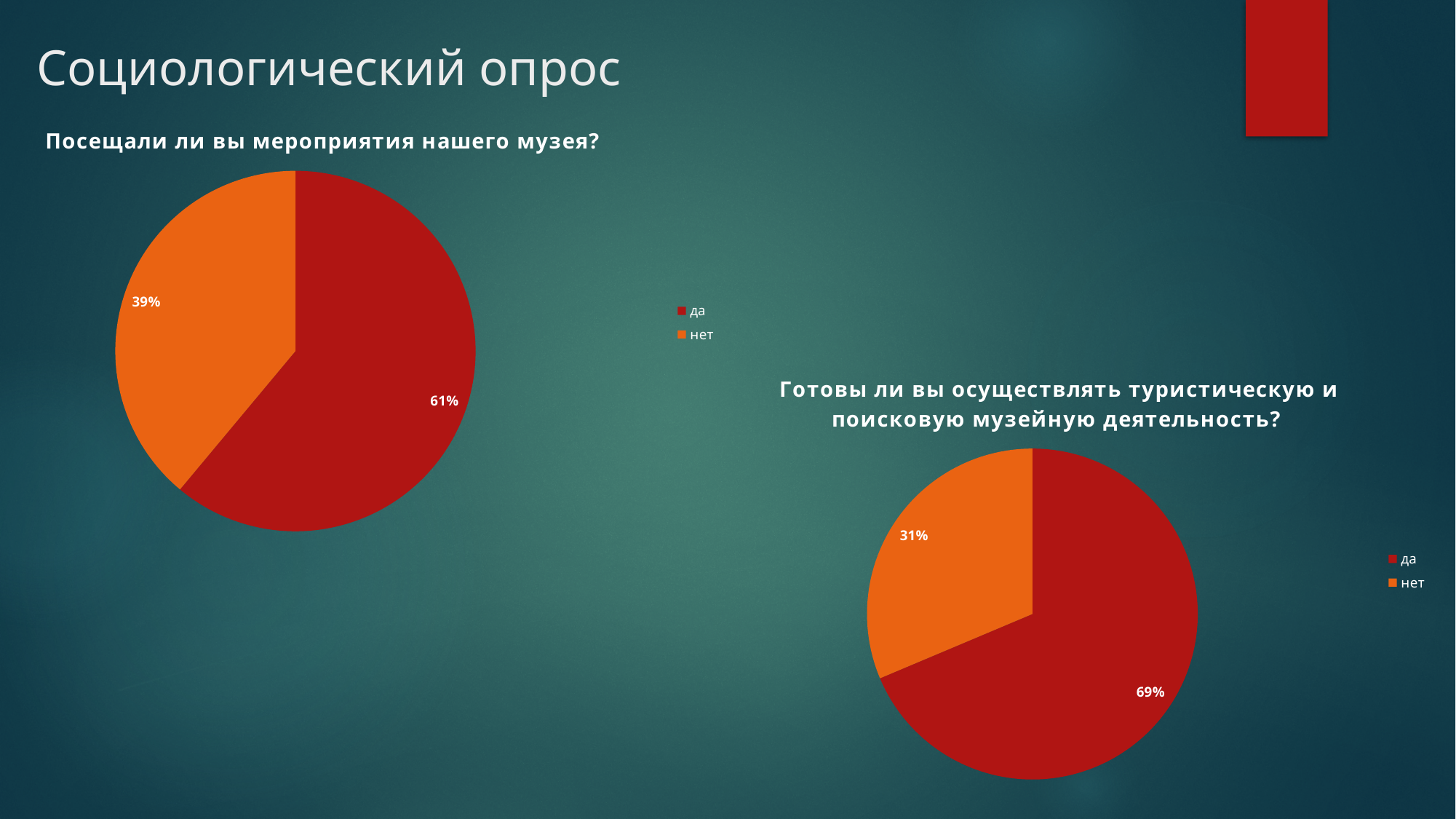
In the chart titled "Посещали ли вы мероприятия нашего музея?", what is the difference between the "да" and "нет" shares? 22% In the chart titled "Посещали ли вы мероприятия нашего музея?", what colour is the "нет" slice? Orange Which chart has the larger "да" share: the one on the left ("Посещали ли вы мероприятия нашего музея?") or the one on the right ("Готовы ли вы осуществлять туристическую и поисковую музейную деятельность?")? The one on the right In the chart titled "Готовы ли вы осуществлять туристическую и поисковую музейную деятельность?", what is the difference between the "да" and "нет" shares? 38% In the chart titled "Готовы ли вы осуществлять туристическую и поисковую музейную деятельность?", what share of the pie is "да"? 69% What kind of chart is the chart titled "Посещали ли вы мероприятия нашего музея?"? Pie chart In the chart titled "Посещали ли вы мероприятия нашего музея?", what share of the pie is "нет"? 39% In the chart titled "Готовы ли вы осуществлять туристическую и поисковую музейную деятельность?", which slice is the smallest? нет In the chart titled "Готовы ли вы осуществлять туристическую и поисковую музейную деятельность?", what share of the pie is "нет"? 31% In the chart titled "Посещали ли вы мероприятия нашего музея?", what share of the pie is "да"? 61% In the chart titled "Посещали ли вы мероприятия нашего музея?", which slice is the largest? да How many slices does the chart titled "Готовы ли вы осуществлять туристическую и поисковую музейную деятельность?" have? 2